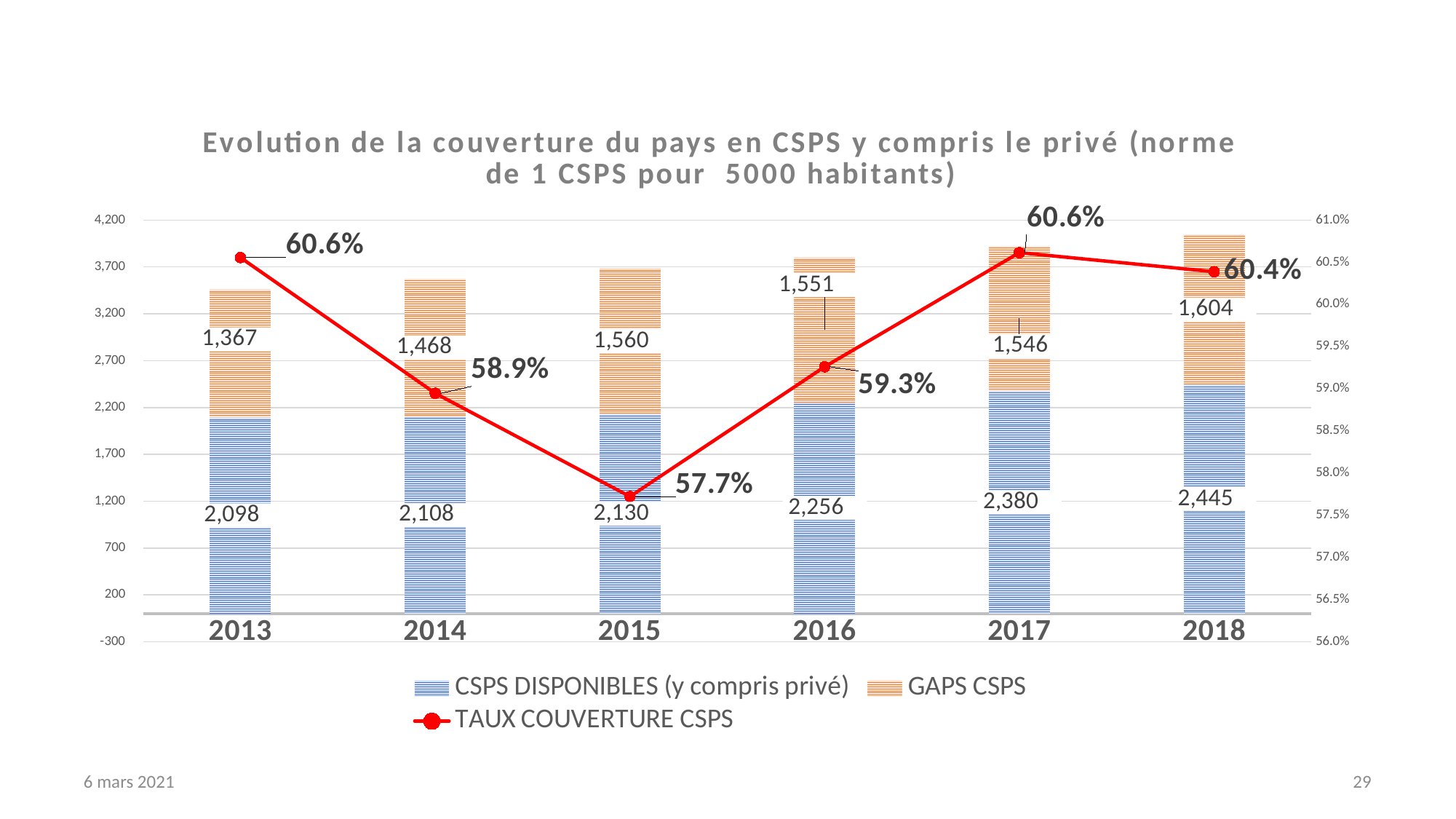
Which year has the highest value of CSPS DISPONIBLES (y compris privé)? 2018 What is the GAPS CSPS value for 2014? 1,468 Which year has the lowest GAPS CSPS value? 2013 What is the value of CSPS DISPONIBLES (y compris privé) for 2016? 2,256 Which year has the lowest TAUX COUVERTURE CSPS? 2015 What is the total of the stacked bar for 2017 (CSPS DISPONIBLES plus GAPS CSPS)? 3,926 Does the CSPS DISPONIBLES (y compris privé) value rise or fall from 2013 to 2018? rise How many series does the legend list? 3 What is the difference between the CSPS DISPONIBLES (y compris privé) values for 2018 and 2013? 347 Is the GAPS CSPS value larger in 2015 or in 2016? 2015 What is the TAUX COUVERTURE CSPS for 2015? 57.7% How many years are shown on the x axis? 6